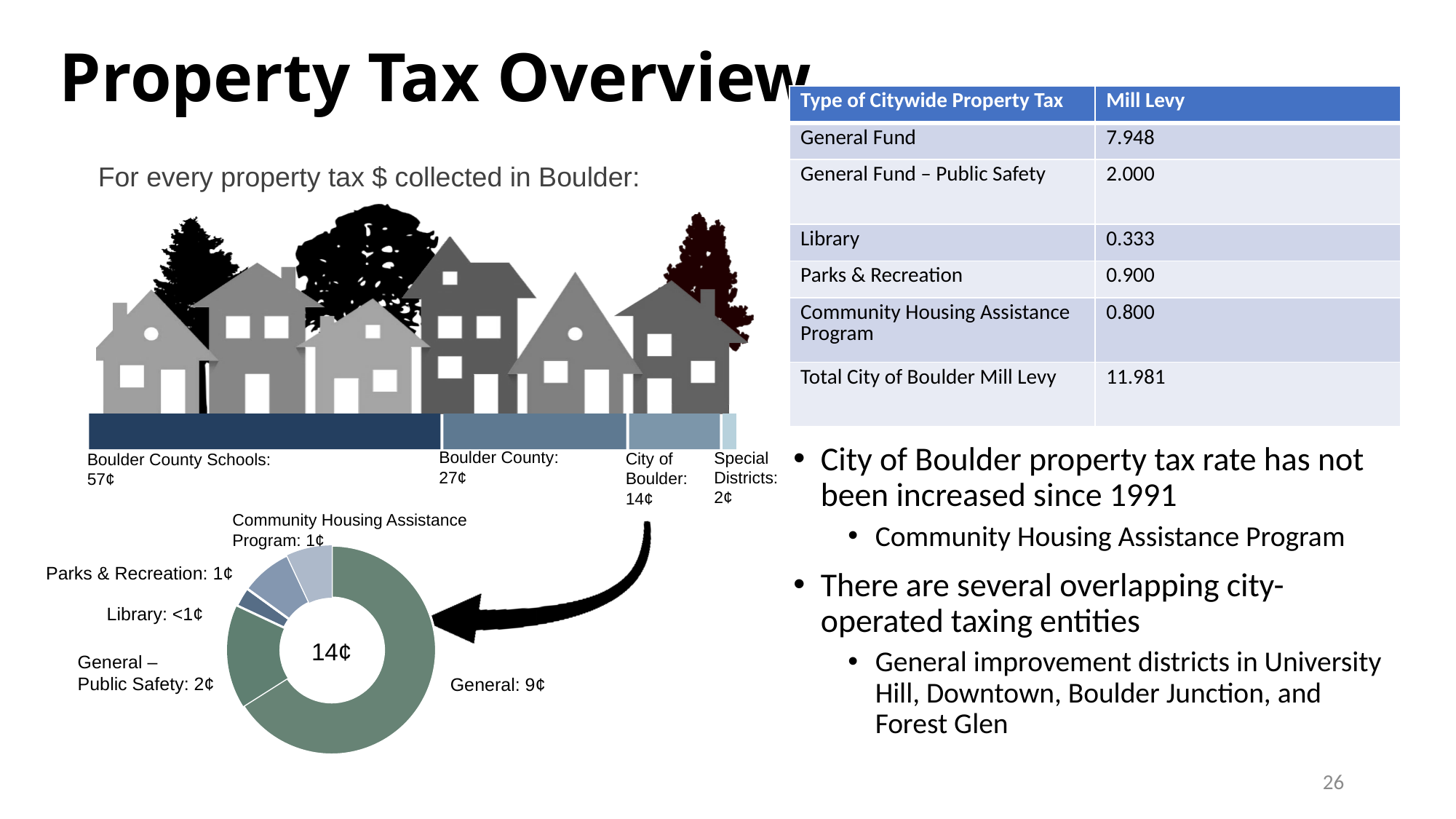
In the horizontal bar chart showing where each property tax dollar goes, what is the value for Boulder County? 27¢ In the donut chart breaking down the City of Boulder's 14¢, what is the value for General – Public Safety? 2¢ In the horizontal bar chart showing where each property tax dollar goes, which segment is the smallest? Special Districts In the horizontal bar chart showing where each property tax dollar goes, which segment is the largest? Boulder County Schools In the horizontal bar chart showing where each property tax dollar goes, how many segments are there? 4 In the horizontal bar chart showing where each property tax dollar goes, what is the value for Special Districts? 2¢ In the horizontal bar chart showing where each property tax dollar goes, what is the value for Boulder County Schools? 57¢ In the donut chart breaking down the City of Boulder's 14¢, what is the value for General? 9¢ In the donut chart breaking down the City of Boulder's 14¢, which slice is the largest? General In the horizontal bar chart showing where each property tax dollar goes, how much larger is the Boulder County Schools share than the Boulder County share? 30¢ What number is printed in the center of the donut chart? 14¢ In the donut chart breaking down the City of Boulder's 14¢, which is larger: General – Public Safety or Parks & Recreation? General – Public Safety